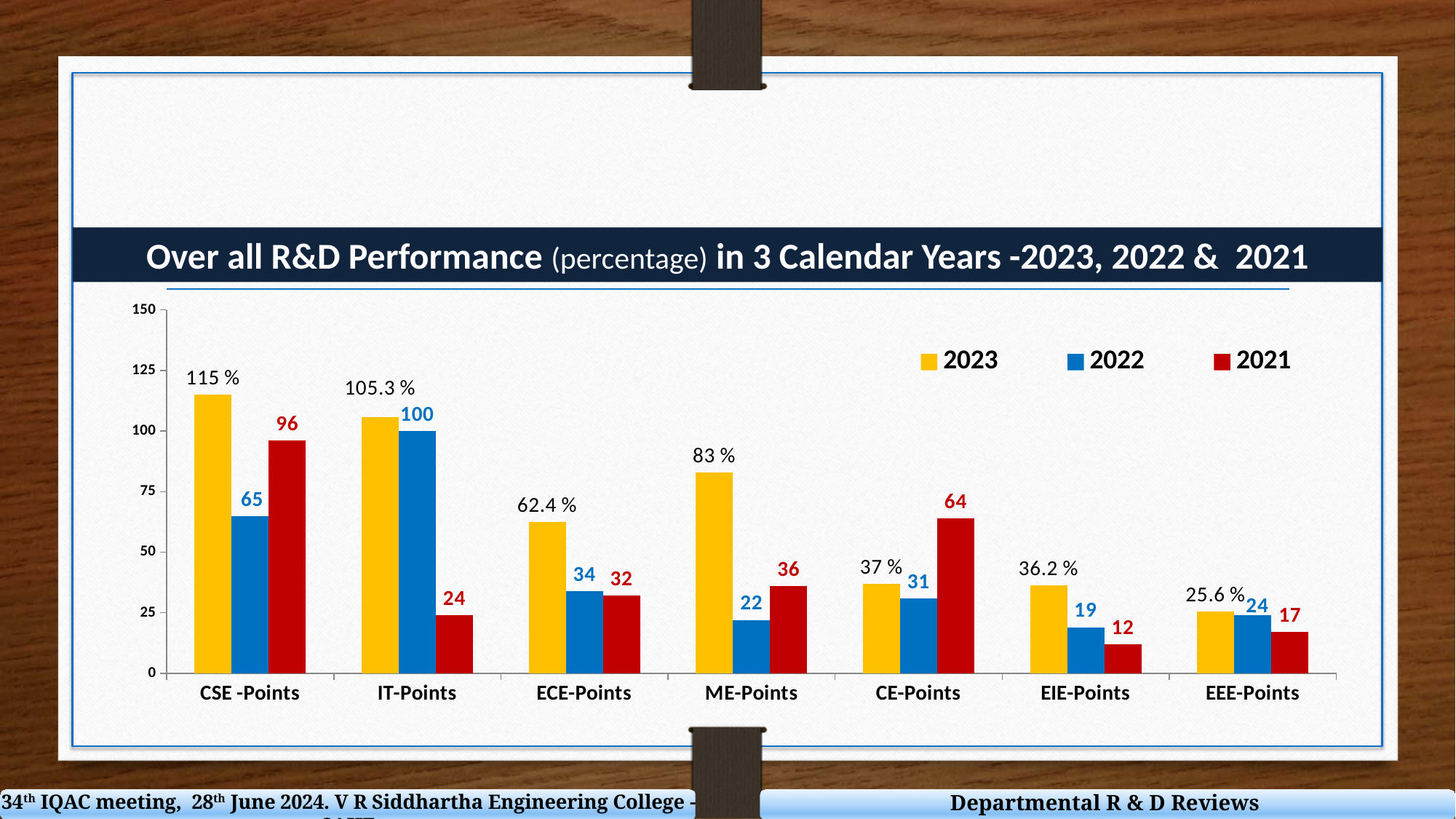
Which department has the highest 2023 value? CSE -Points What is the 2021 value for CE-Points? 64 Which is larger for ME-Points: the 2022 value or the 2021 value? 2021 Which department has the lowest 2021 value? EIE-Points What is the 2023 value for EEE-Points? 25.6 % Is the 2023 value for ECE-Points greater or less than 50? greater How many series does the legend list? 3 What is the difference between the 2021 values for CSE -Points and IT-Points? 72 How many departments are shown on the x axis? 7 What is the 2022 value for IT-Points? 100 What is the 2023 value for CSE -Points? 115 % What kind of chart is shown on the slide? bar chart